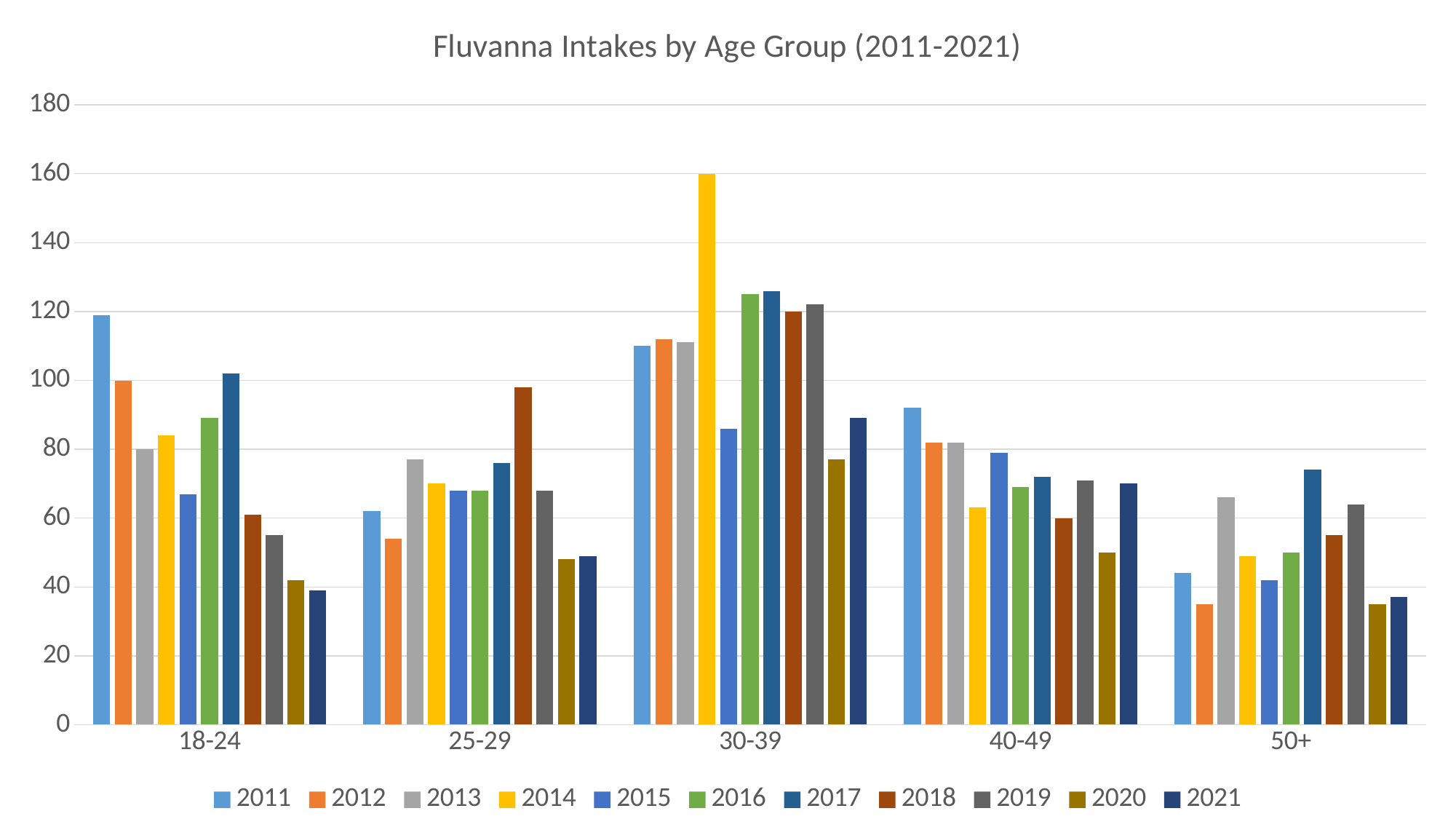
How many age groups are shown on the x axis? 5 Is the value for 2018 in the 25-29 age group greater or less than 80? greater Which year has the highest value in the 18-24 age group? 2011 What is the value for 2014 in the 30-39 age group? 160 Is the value for 2015 in the 30-39 age group greater or less than 100? less What type of chart is shown on the slide? bar chart How many series does the legend list? 11 Which year has the lowest value in the 40-49 age group? 2020 Which is larger: the 2016 value for 18-24 or the 2016 value for 25-29? 18-24 What is the value for 2012 in the 18-24 age group? 100 Which year has the highest value in the 30-39 age group? 2014 What is the title of the chart? Fluvanna Intakes by Age Group (2011-2021)